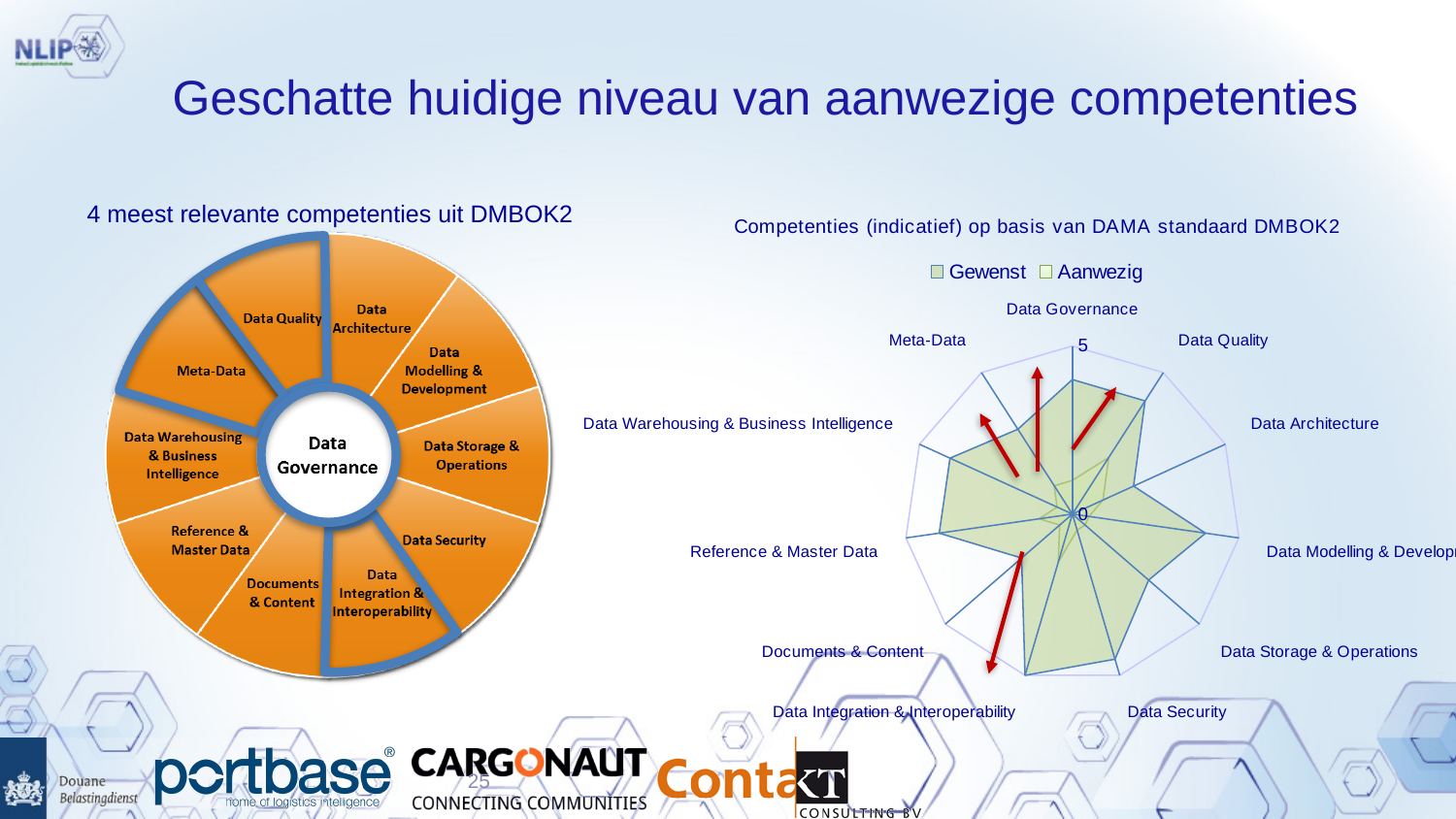
In the radar chart, is the Aanwezig value for Data Security greater or less than 5? less What kind of chart is shown on the right side of the slide? Radar chart What is the maximum value shown on the axis of the radar chart? 5 What is the title of the radar chart? Competenties (indicatief) op basis van DAMA standaard DMBOK2 How many series does the legend of the radar chart list? 2 What is the minimum value shown on the axis of the radar chart? 0 Which category sits at the top of the radar chart? Data Governance How many competency categories (axes) does the radar chart have? 11 What are the two series named in the legend of the radar chart? Gewenst and Aanwezig In the radar chart, is the Aanwezig value for Data Quality greater or less than 5? less